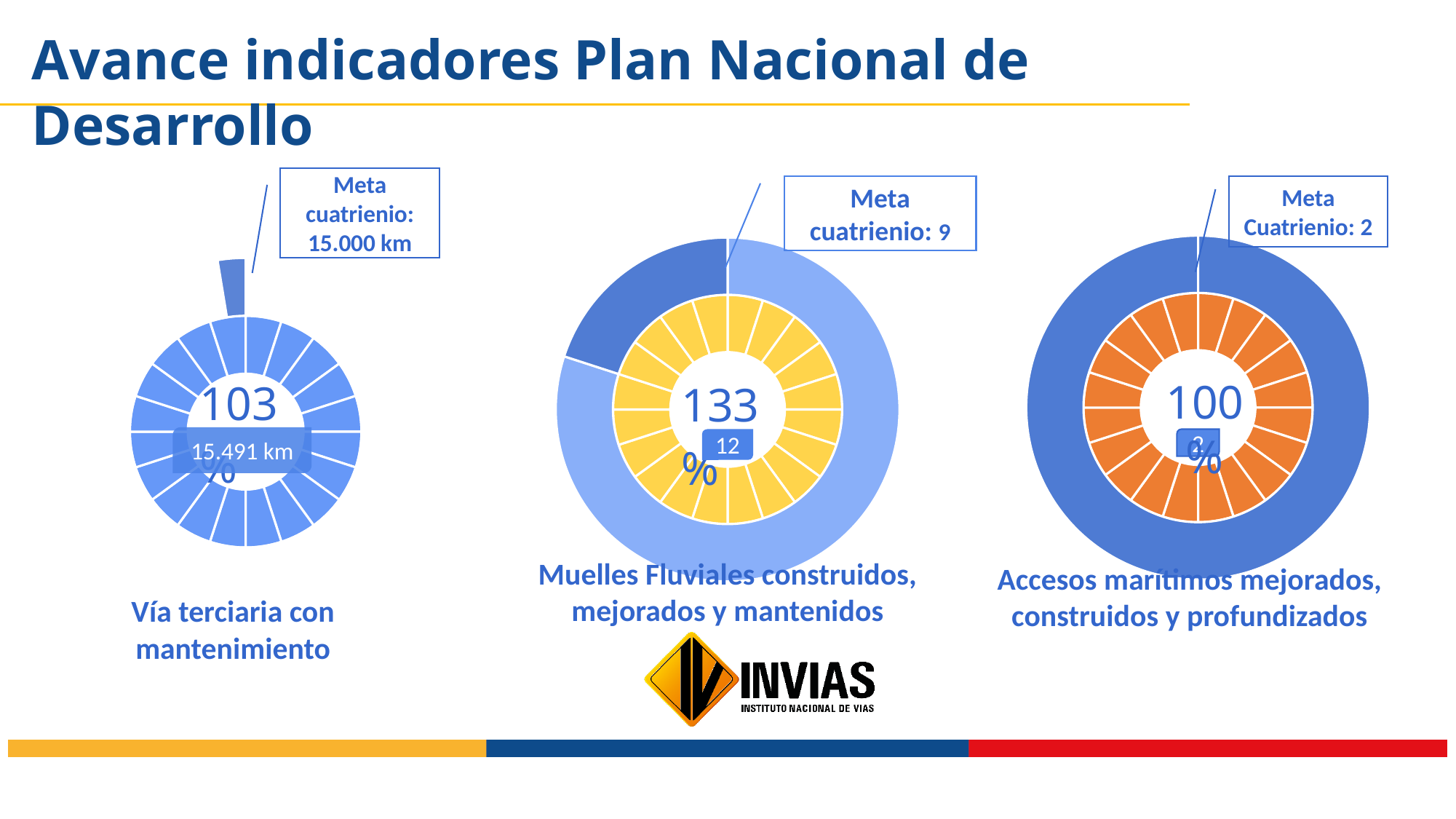
On the 'Muelles Fluviales construidos, mejorados y mantenidos' chart, what is the 'Meta cuatrienio' target? 9 How many indicator charts are shown on the slide? 3 Which indicator on the slide shows the lowest percentage of progress? Accesos marítimos mejorados, construidos y profundizados On the 'Vía terciaria con mantenimiento' chart, how many kilometres are shown as achieved? 15.491 km On the 'Muelles Fluviales construidos, mejorados y mantenidos' chart, what number of muelles is shown as achieved? 12 On the 'Muelles Fluviales construidos, mejorados y mantenidos' chart, by how many muelles does the achieved value (12) exceed the target (9)? 3 On the 'Muelles Fluviales construidos, mejorados y mantenidos' chart, what percentage of progress is shown in the centre? 133% Which indicator on the slide shows the highest percentage of progress? Muelles Fluviales construidos, mejorados y mantenidos On the 'Vía terciaria con mantenimiento' chart, what is the 'Meta cuatrienio' target? 15.000 km On the 'Accesos marítimos mejorados, construidos y profundizados' chart, what percentage of progress is shown in the centre? 100% On the 'Vía terciaria con mantenimiento' chart, what percentage of progress is shown in the centre? 103% On the 'Accesos marítimos mejorados, construidos y profundizados' chart, what is the 'Meta Cuatrienio' target? 2